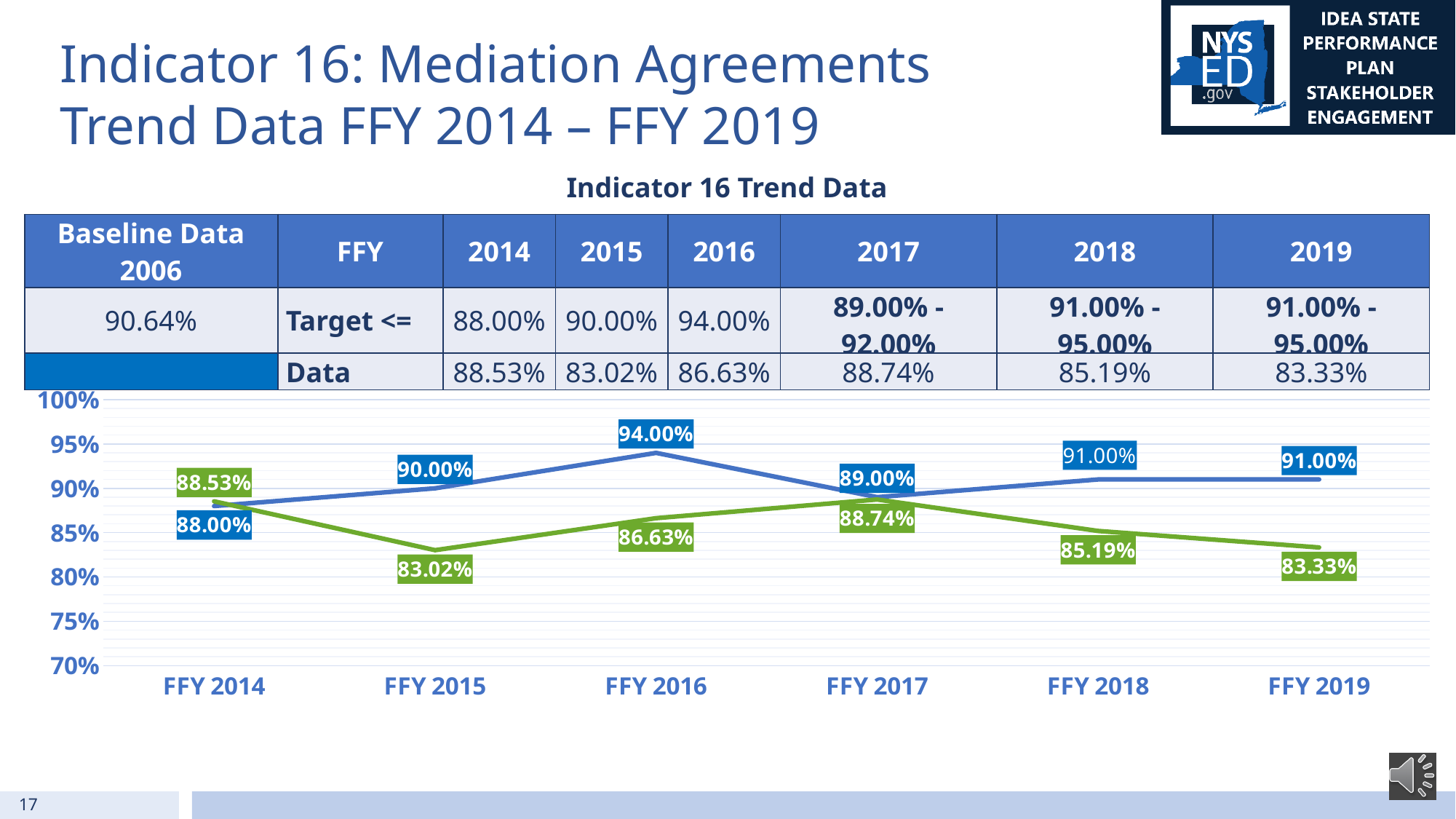
What is the difference between the blue (Target) value and the green (Data) value for FFY 2018? 5.81% Does the green (Data) line rise or fall from FFY 2017 to FFY 2019? fall In which FFY does the green (Data) line reach its lowest value? FFY 2015 Which is larger for FFY 2014: the green (Data) value or the blue (Target) value? Data (88.53%) What is the value of the green (Data) line for FFY 2019? 83.33% What is the value of the green (Data) line for FFY 2015? 83.02% What type of chart is shown on the slide? line chart In which FFY does the green (Data) line reach its highest value? FFY 2017 In which FFY does the blue (Target) line reach its highest value? FFY 2016 How many FFY categories are plotted along the x axis of the chart? 6 What is the value of the blue (Target) line for FFY 2016? 94.00% What is the title of the chart? Indicator 16 Trend Data